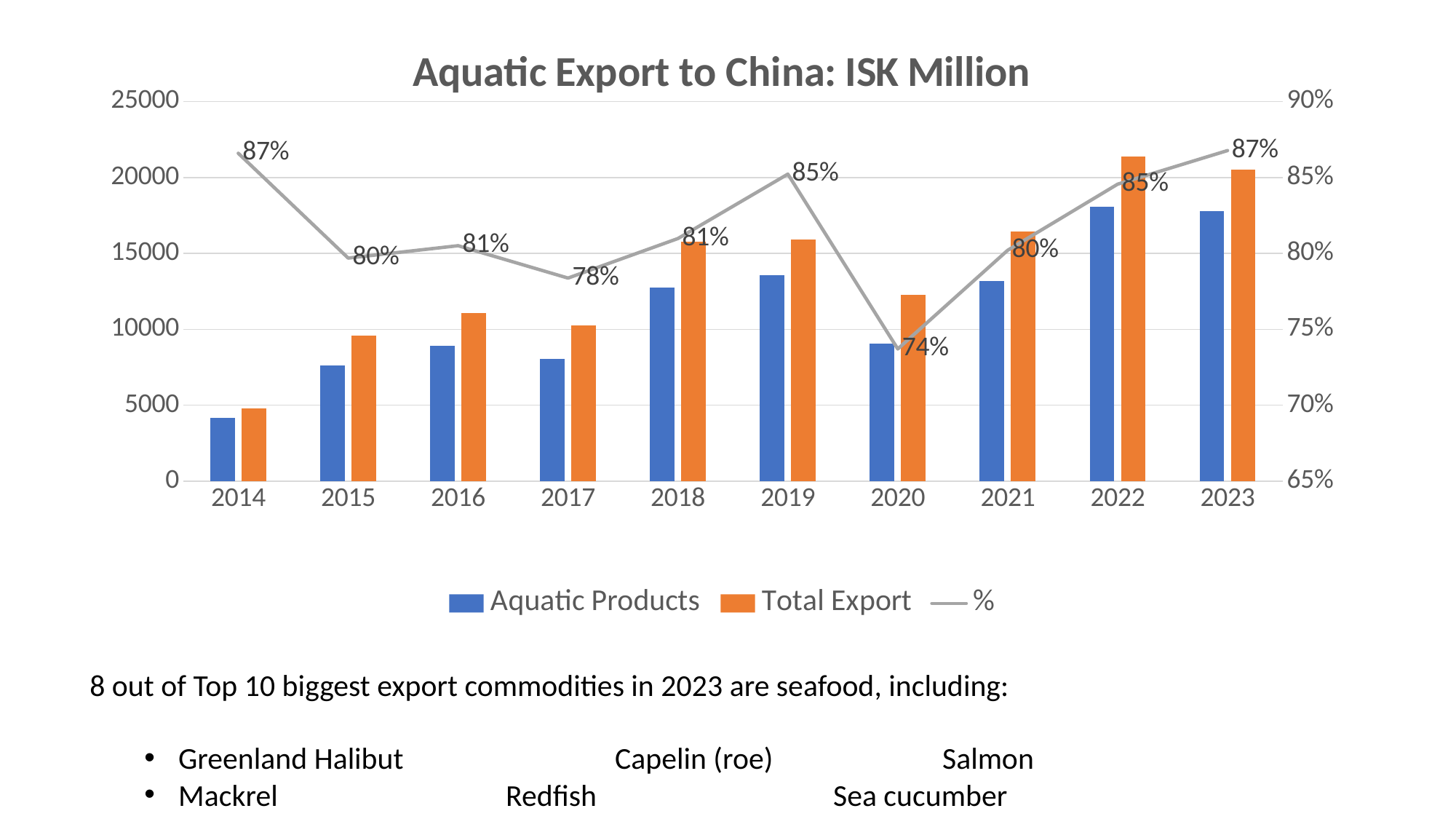
How many series does the legend list? 3 What is the value of the % series for 2020? 74% Which year has the larger Total Export bar, 2022 or 2023? 2022 How many years are shown on the x axis? 10 In which year is the Total Export bar the highest? 2022 What is the value of the % series for 2017? 78% Is the Aquatic Products value for 2023 greater or less than 15000? greater In which year is the % series at its lowest? 2020 In which year is the Aquatic Products bar the lowest? 2014 By how many percentage points does the % series fall from 2019 to 2020? 11 percentage points What is the value of the % series for 2014? 87% Is the Aquatic Products value for 2020 greater or less than 10000? less